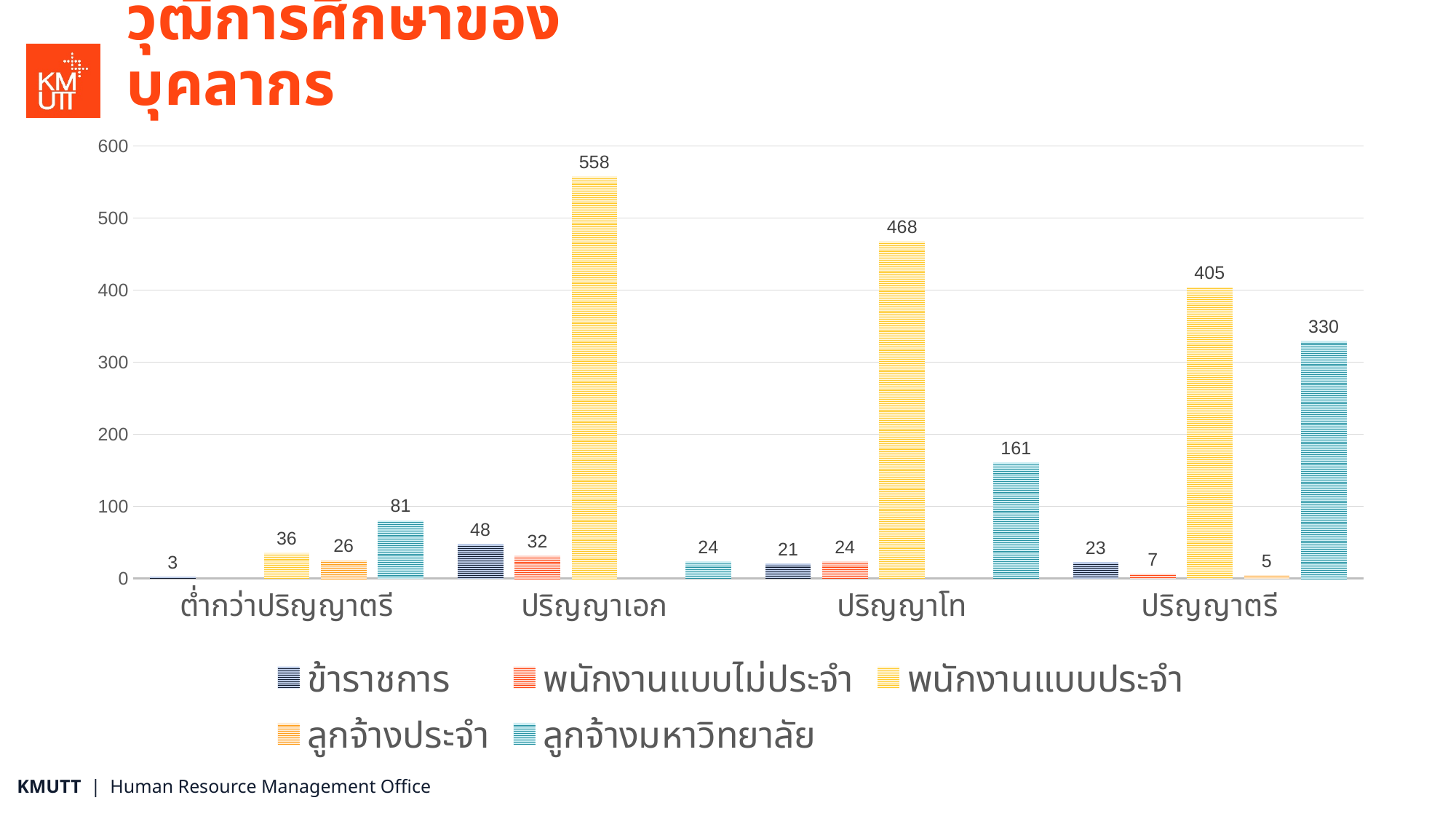
How many categories are shown on the x axis? 4 What is the difference between the พนักงานแบบประจำ values for ปริญญาเอก and ปริญญาโท? 90 How many series does the legend list? 5 In which category is the ลูกจ้างมหาวิทยาลัย series lowest? ปริญญาเอก What kind of chart is shown on the slide? bar chart In which category is the พนักงานแบบประจำ series highest? ปริญญาเอก What is the value for ลูกจ้างมหาวิทยาลัย in the ปริญญาตรี category? 330 Which is larger: ลูกจ้างมหาวิทยาลัย in ปริญญาโท or ลูกจ้างมหาวิทยาลัย in ปริญญาตรี? ปริญญาตรี What is the value for ข้าราชการ in the ต่ำกว่าปริญญาตรี category? 3 Is the value for พนักงานแบบประจำ in ปริญญาตรี greater or less than 400? greater What is the value for พนักงานแบบประจำ in the ปริญญาเอก category? 558 What is the value for ลูกจ้างประจำ in the ปริญญาตรี category? 5